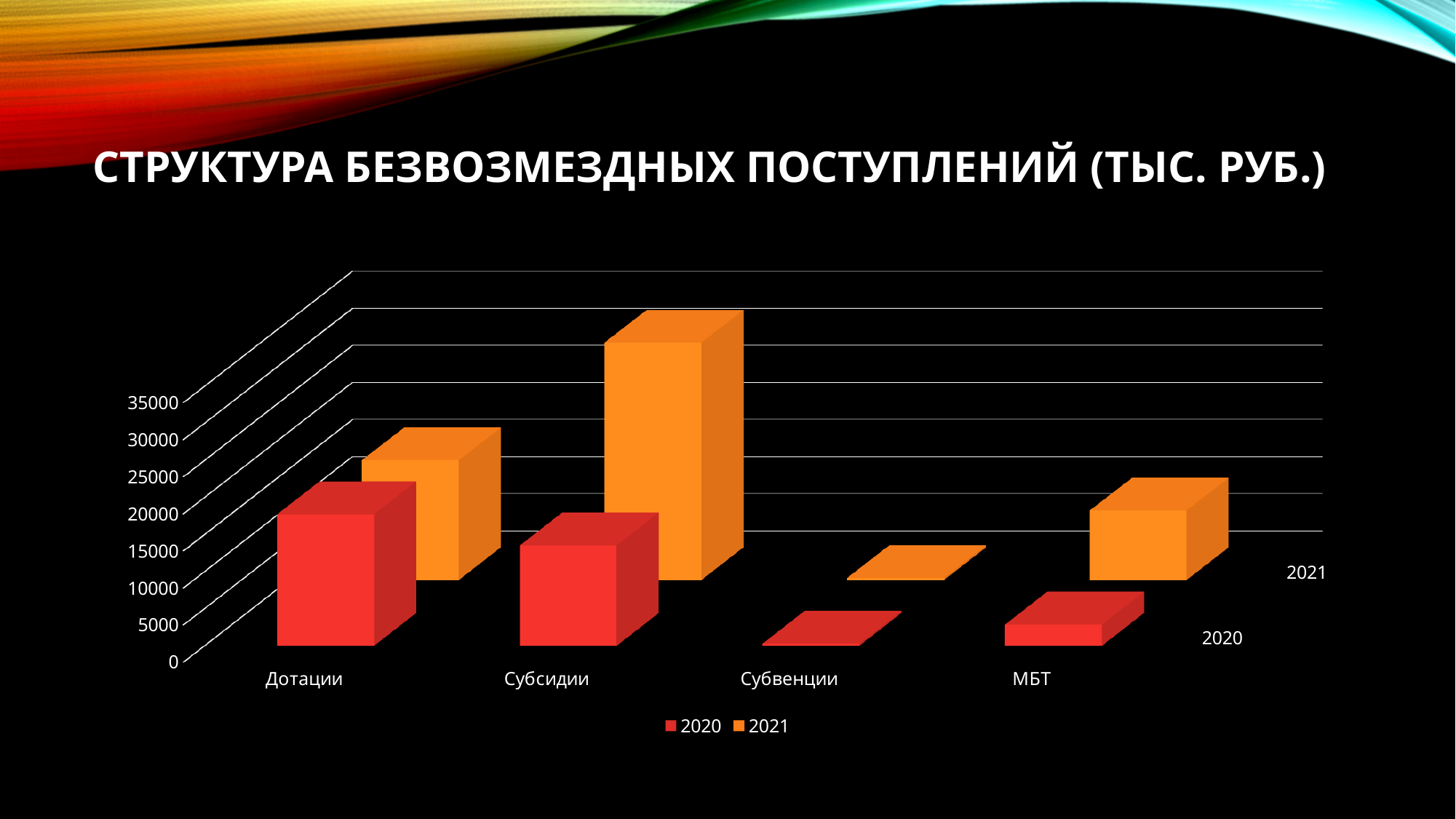
How many categories are shown on the x axis? 4 Which category has the highest value for the 2021 series? Субсидии How many series does the legend list? 2 For the 2020 series, which is larger: Дотации or Субсидии? Дотации Is the 2020 value for Субвенции greater or less than 5000? less Which colour represents the 2021 series in the legend? orange Which category has the lowest value for the 2020 series? Субвенции For the 2021 series, which is larger: Субсидии or Дотации? Субсидии Which category has the lowest value for the 2021 series? Субвенции What is the title of the chart? СТРУКТУРА БЕЗВОЗМЕЗДНЫХ ПОСТУПЛЕНИЙ (ТЫС. РУБ.) What kind of chart is shown on the slide? bar chart Which category has the highest value for the 2020 series? Дотации